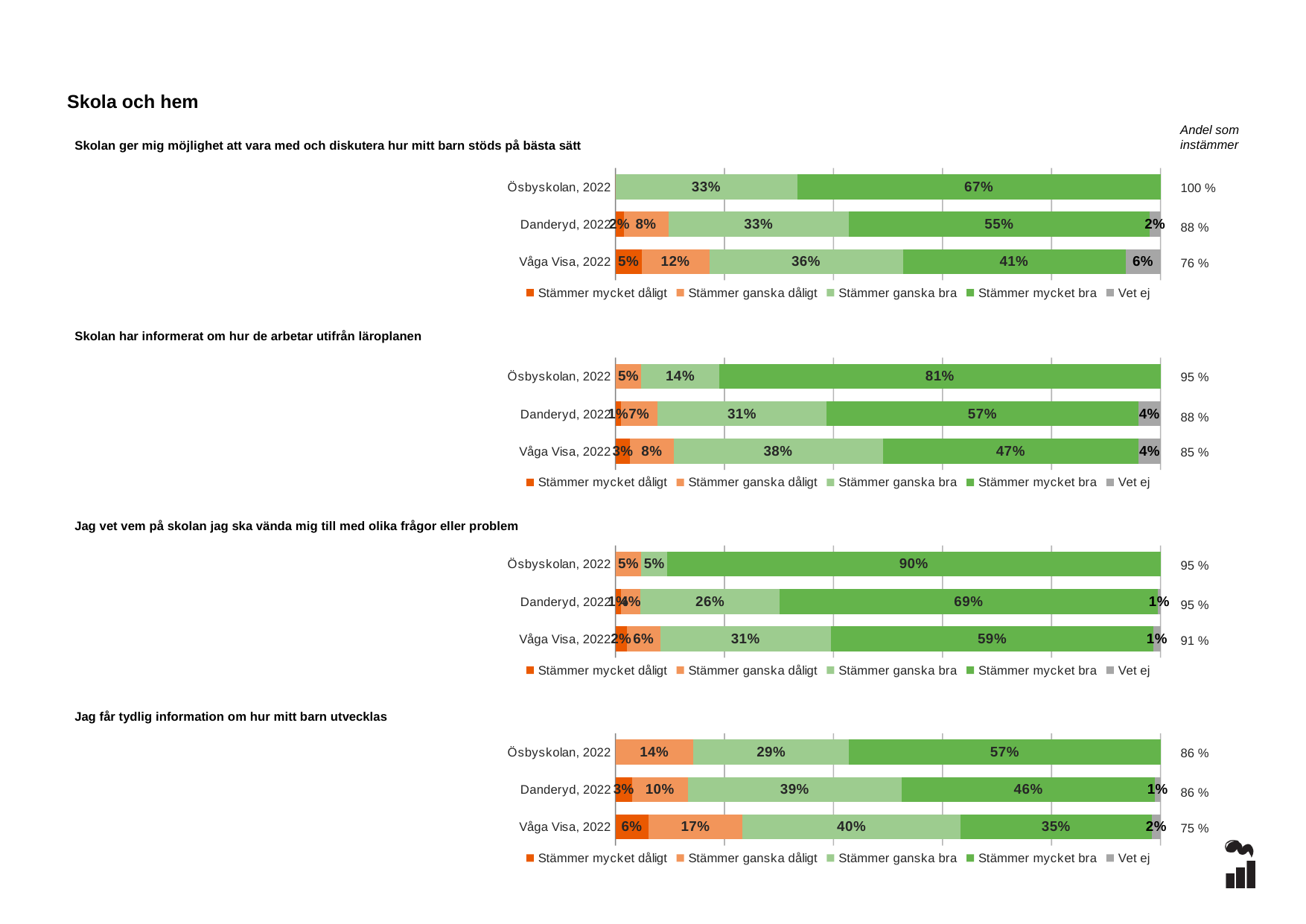
What kind of chart is used for 'Jag får tydlig information om hur mitt barn utvecklas'? Stacked bar chart In the chart 'Skolan har informerat om hur de arbetar utifrån läroplanen', what is the 'Stämmer mycket bra' value for Danderyd, 2022? 57% How many rows (categories) does the chart 'Skolan ger mig möjlighet att vara med och diskutera hur mitt barn stöds på bästa sätt' have? 3 In the chart 'Skolan har informerat om hur de arbetar utifrån läroplanen', which row has the highest 'Stämmer mycket bra' value? Ösbyskolan, 2022 In the chart 'Skolan ger mig möjlighet att vara med och diskutera hur mitt barn stöds på bästa sätt', what is the 'Stämmer mycket bra' value for Ösbyskolan, 2022? 67% In the chart 'Jag får tydlig information om hur mitt barn utvecklas', what is the 'Andel som instämmer' value shown for Våga Visa, 2022? 75 % In the chart 'Jag får tydlig information om hur mitt barn utvecklas', which row has the lowest 'Stämmer mycket bra' value? Våga Visa, 2022 In the chart 'Skolan ger mig möjlighet att vara med och diskutera hur mitt barn stöds på bästa sätt', what is the 'Stämmer ganska dåligt' value for Våga Visa, 2022? 12% In the chart 'Jag vet vem på skolan jag ska vända mig till med olika frågor eller problem', which is larger: the 'Stämmer ganska bra' value for Danderyd, 2022 or for Våga Visa, 2022? Våga Visa, 2022 In the chart 'Jag får tydlig information om hur mitt barn utvecklas', what is the 'Stämmer ganska dåligt' value for Ösbyskolan, 2022? 14% How many series does the legend of the chart 'Skolan har informerat om hur de arbetar utifrån läroplanen' list? 5 In the chart 'Jag vet vem på skolan jag ska vända mig till med olika frågor eller problem', what is the difference between the 'Stämmer mycket bra' values for Ösbyskolan, 2022 and Danderyd, 2022? 21%